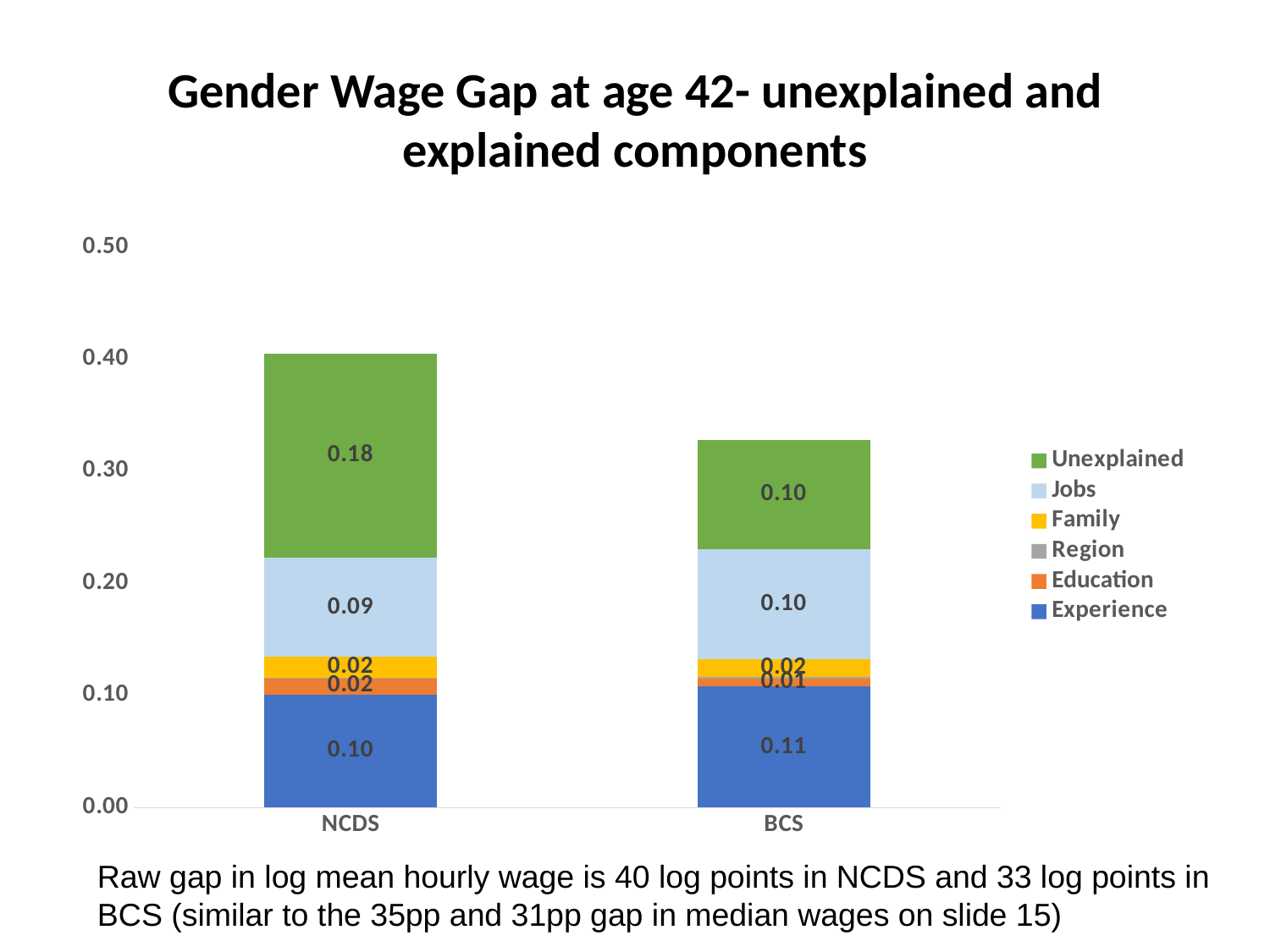
What is the Unexplained value for NCDS? 0.18 What is the Experience value for NCDS? 0.10 What type of chart is shown on the slide? Stacked bar chart How many series does the legend list? 6 What is the Education value for BCS? 0.01 What colour represents the Unexplained series in the legend? Green What is the Jobs value for BCS? 0.10 What is the difference between the Unexplained values for NCDS and BCS? 0.08 How many categories are shown on the x axis? 2 Which has the larger Unexplained value, NCDS or BCS? NCDS Is the total height of the BCS bar greater or less than 0.30? greater Which component is the largest in the NCDS bar? Unexplained